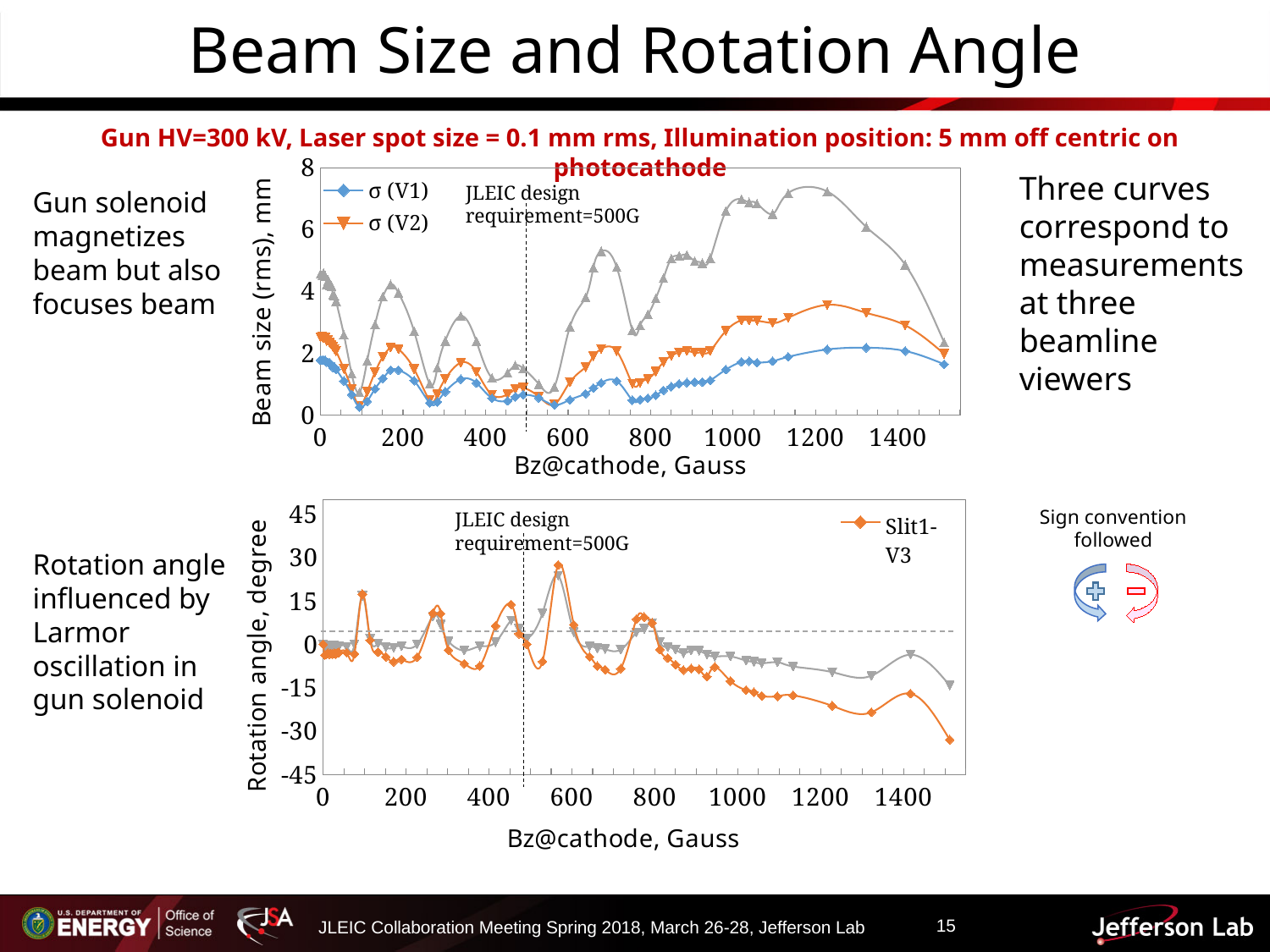
In the top chart (Beam size), at Bz = 1200 Gauss, which is larger: σ (V1) or σ (V2)? σ (V2) What kind of chart is the top chart (Beam size vs Bz@cathode)? line chart In the bottom chart (Rotation angle), is the value of Slit1-V3 at Bz = 1300 Gauss greater or less than -15 degrees? less How many series does the legend of the top chart (Beam size) list? 2 In the bottom chart (Rotation angle), is the peak value of Slit1-V3 near Bz = 600 Gauss greater or less than 15 degrees? greater In the top chart (Beam size), is the value of σ (V1) at Bz = 600 Gauss greater or less than 2 mm? less In the bottom chart (Rotation angle), does the Slit1-V3 curve generally rise or fall between Bz = 800 and Bz = 1500 Gauss? fall How many series does the legend of the bottom chart (Rotation angle) list? 1 What is the x-axis label shared by both charts? Bz@cathode, Gauss In the top chart (Beam size), which legend series has the lowest beam size values overall? σ (V1) In the top chart (Beam size), which plotted series reaches the highest beam size values? the gray (unlabeled) series